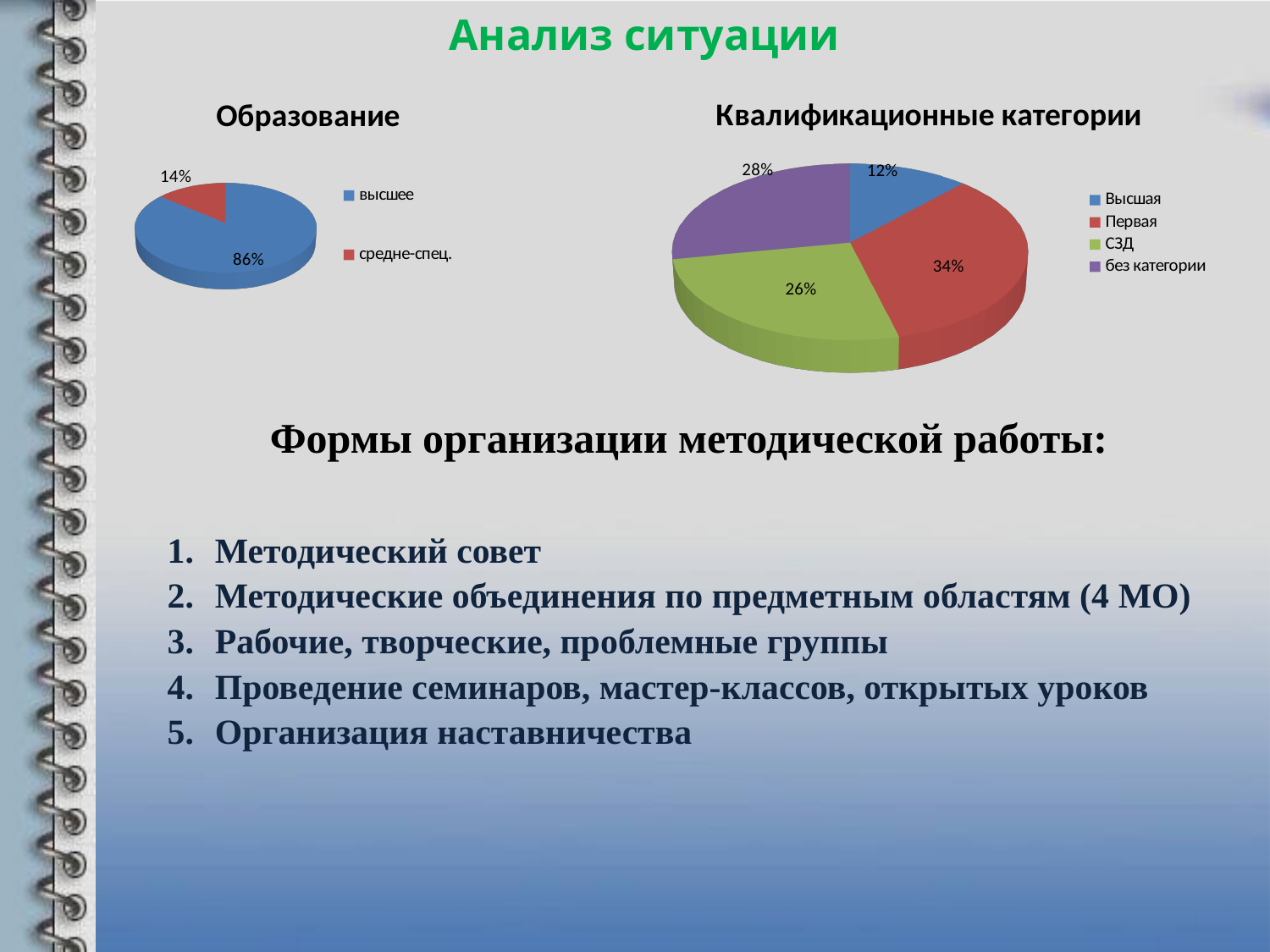
In the "Образование" chart, what share is labelled for "высшее"? 86% In the "Квалификационные категории" chart, which category has the largest share? Первая In the "Квалификационные категории" chart, which category has the smallest share? Высшая What kind of chart is the "Образование" chart? Pie chart How many entries does the legend of the "Квалификационные категории" chart list? 4 In the "Квалификационные категории" chart, what share is labelled for "Первая"? 34% In the "Квалификационные категории" chart, what share is labelled for "СЗД"? 26% In the "Квалификационные категории" chart, what is the difference between the shares for "Первая" and "Высшая"? 22% How many slices does the "Образование" pie chart have? 2